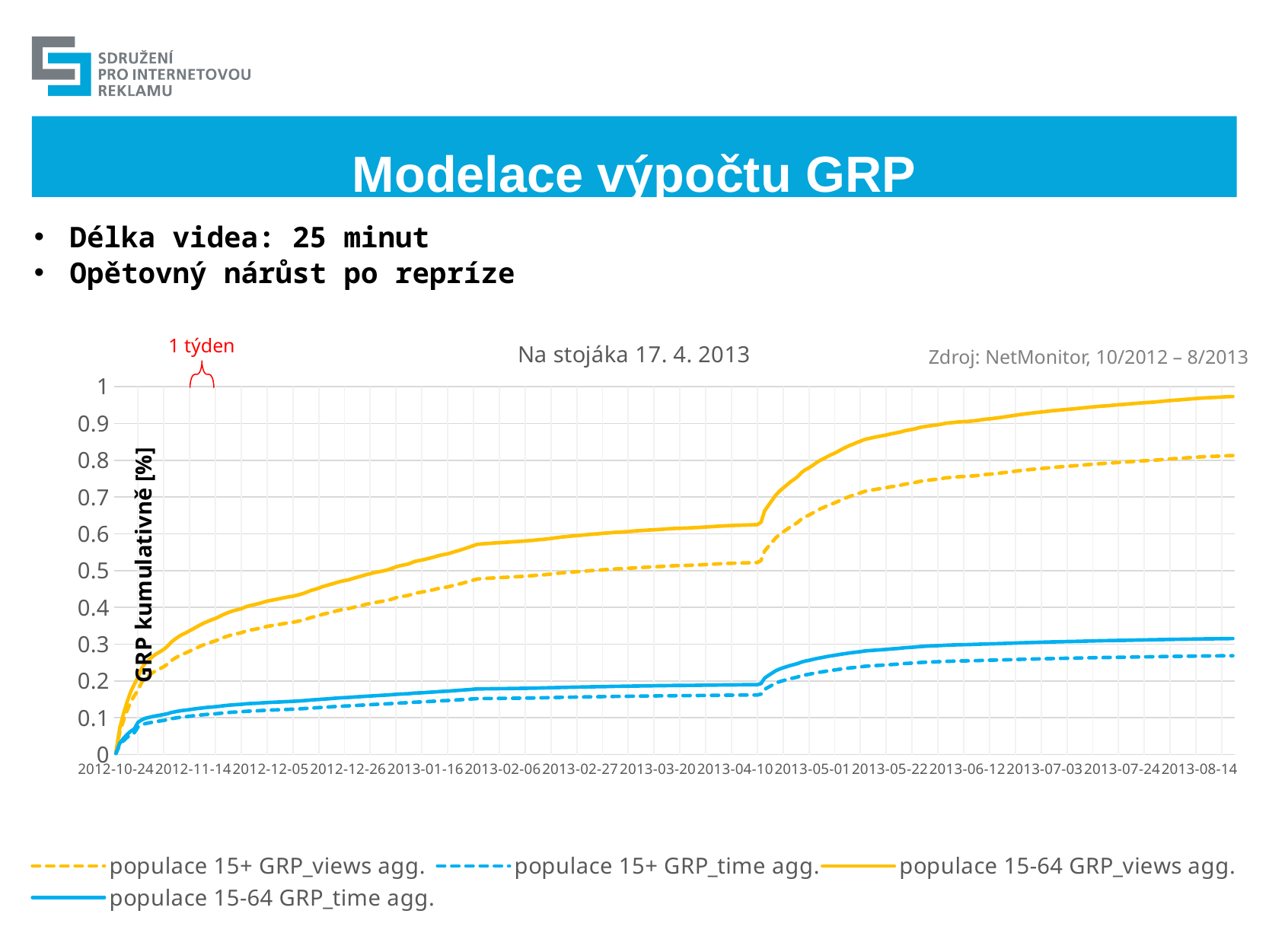
How many date labels are shown on the x axis of the chart? 15 Is the value for 'populace 15+ GRP_views agg.' at 2013-04-10 greater or less than 0.6? less How many series does the chart legend list? 4 What kind of chart is shown on the slide? line chart Which series has the lowest values on the chart? populace 15+ GRP_time agg. What is the title of the chart? Na stojáka 17. 4. 2013 Is the value for 'populace 15+ GRP_time agg.' at 2013-08-14 greater or less than 0.3? less Is the value for 'populace 15-64 GRP_views agg.' at 2013-08-14 greater or less than 0.9? greater What is the label of the vertical axis of the chart? GRP kumulativně [%] At 2013-08-14, which is larger: 'populace 15+ GRP_views agg.' or 'populace 15-64 GRP_time agg.'? populace 15+ GRP_views agg. Which series reaches the highest value on the chart? populace 15-64 GRP_views agg. Do the values of the series 'populace 15-64 GRP_views agg.' rise or fall along the x axis? rise